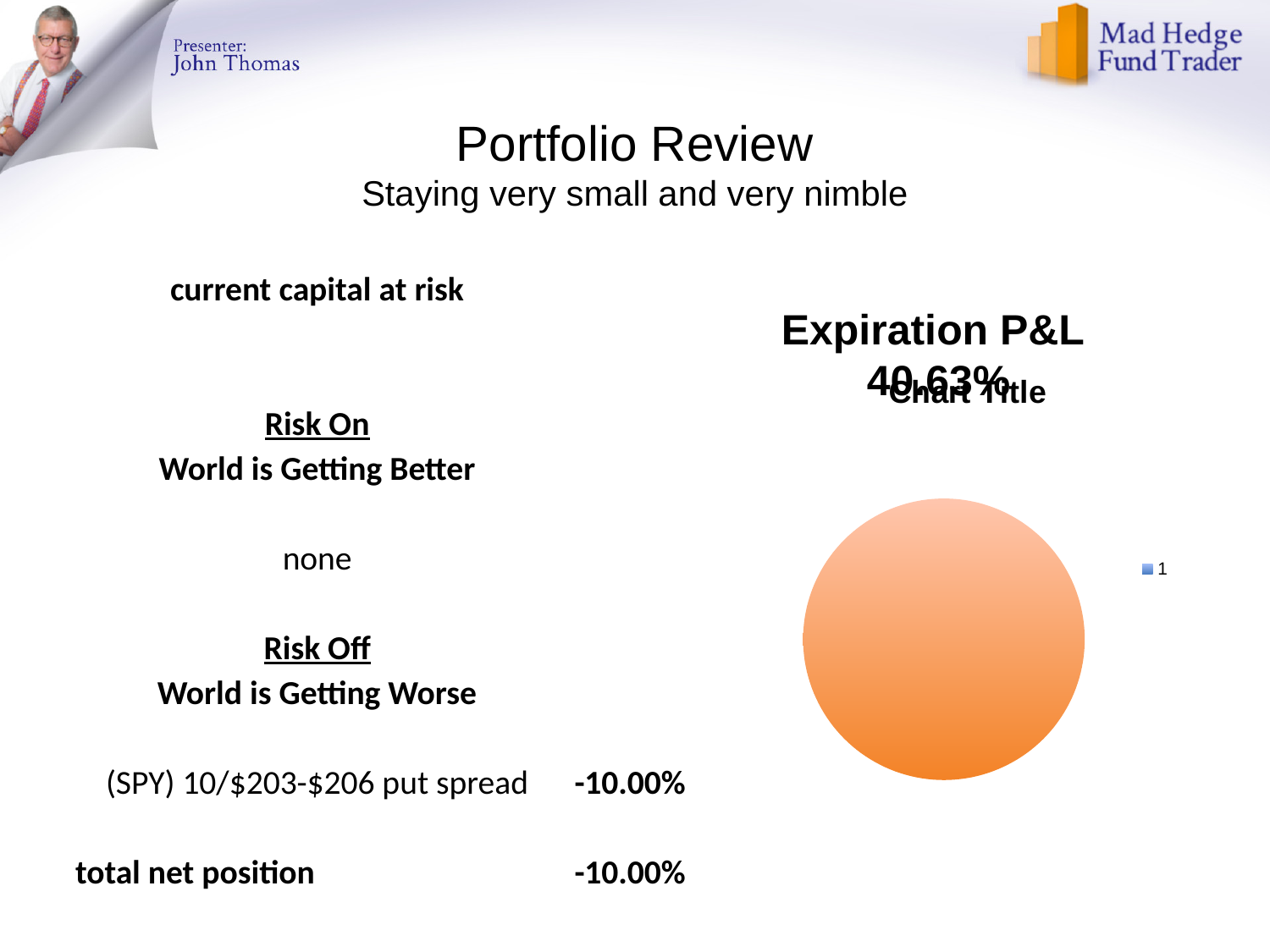
How many slices does the pie chart have? 1 What kind of chart is shown on the slide? pie chart What share of the pie does the single slice take up? 100% What colour is the slice of the pie chart? orange How many entries does the pie chart's legend list? 1 What is the label of the entry shown in the pie chart's legend? 1